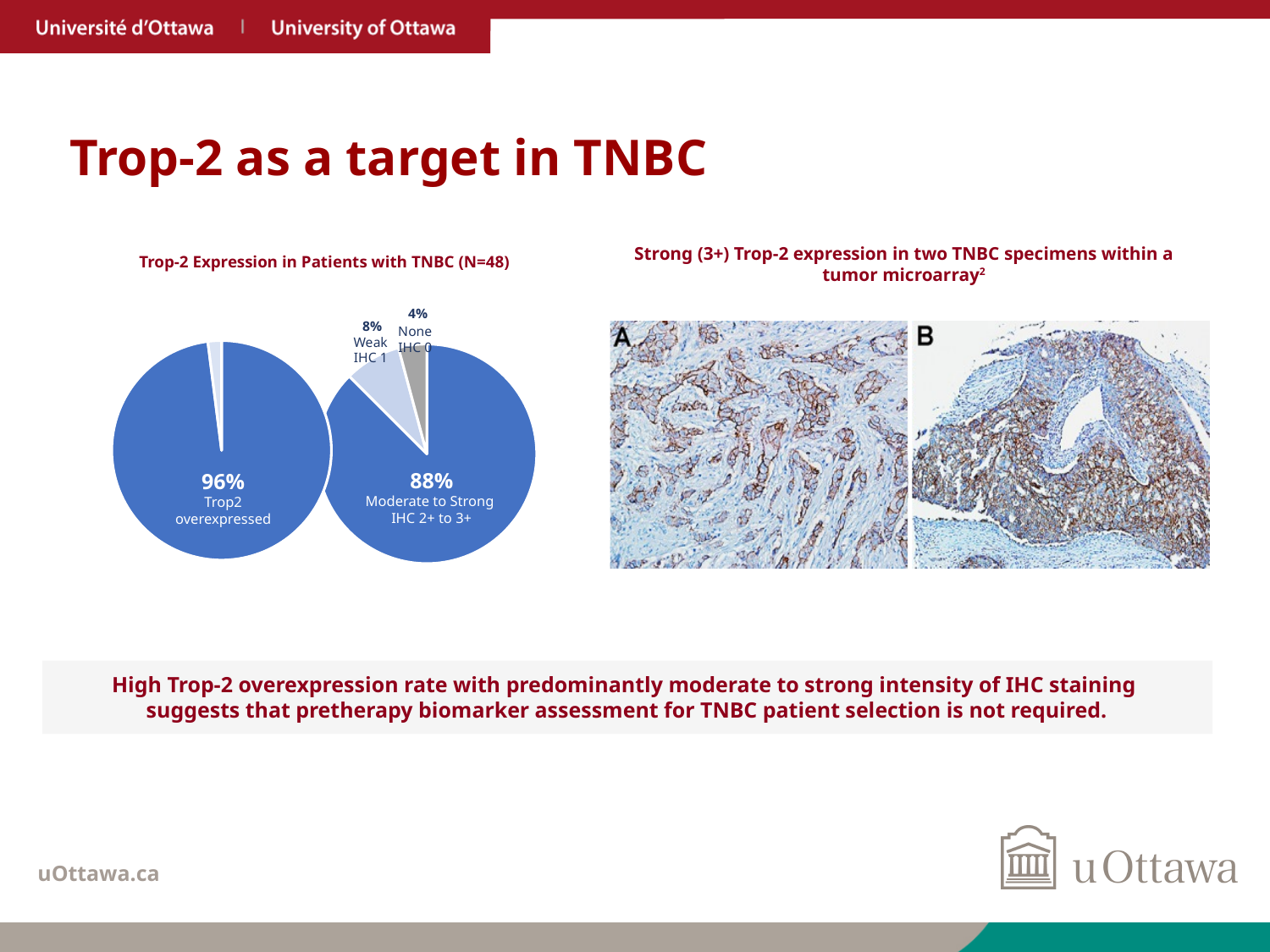
In the right pie chart, which category has the smallest share? None IHC 0 In the left pie chart, what percentage of patients had Trop2 overexpressed? 96% How many labelled slices does the right pie chart have? 3 In the right pie chart, what percentage of patients had Moderate to Strong (IHC 2+ to 3+) expression? 88% In the right pie chart, which category has the largest share? Moderate to Strong IHC 2+ to 3+ What kind of charts are shown under the heading 'Trop-2 Expression in Patients with TNBC (N=48)'? Pie charts In the right pie chart, what percentage of patients had Weak (IHC 1) expression? 8% In the right pie chart, what is the difference in percentage points between the Moderate to Strong slice and the Weak slice? 80 What is the title above the two pie charts? Trop-2 Expression in Patients with TNBC (N=48) In the right pie chart, what percentage of patients had None (IHC 0) expression? 4% What is the sample size (N) stated in the title of the pie charts? 48 In the right pie chart, which is larger: the Weak (IHC 1) slice or the None (IHC 0) slice? Weak IHC 1